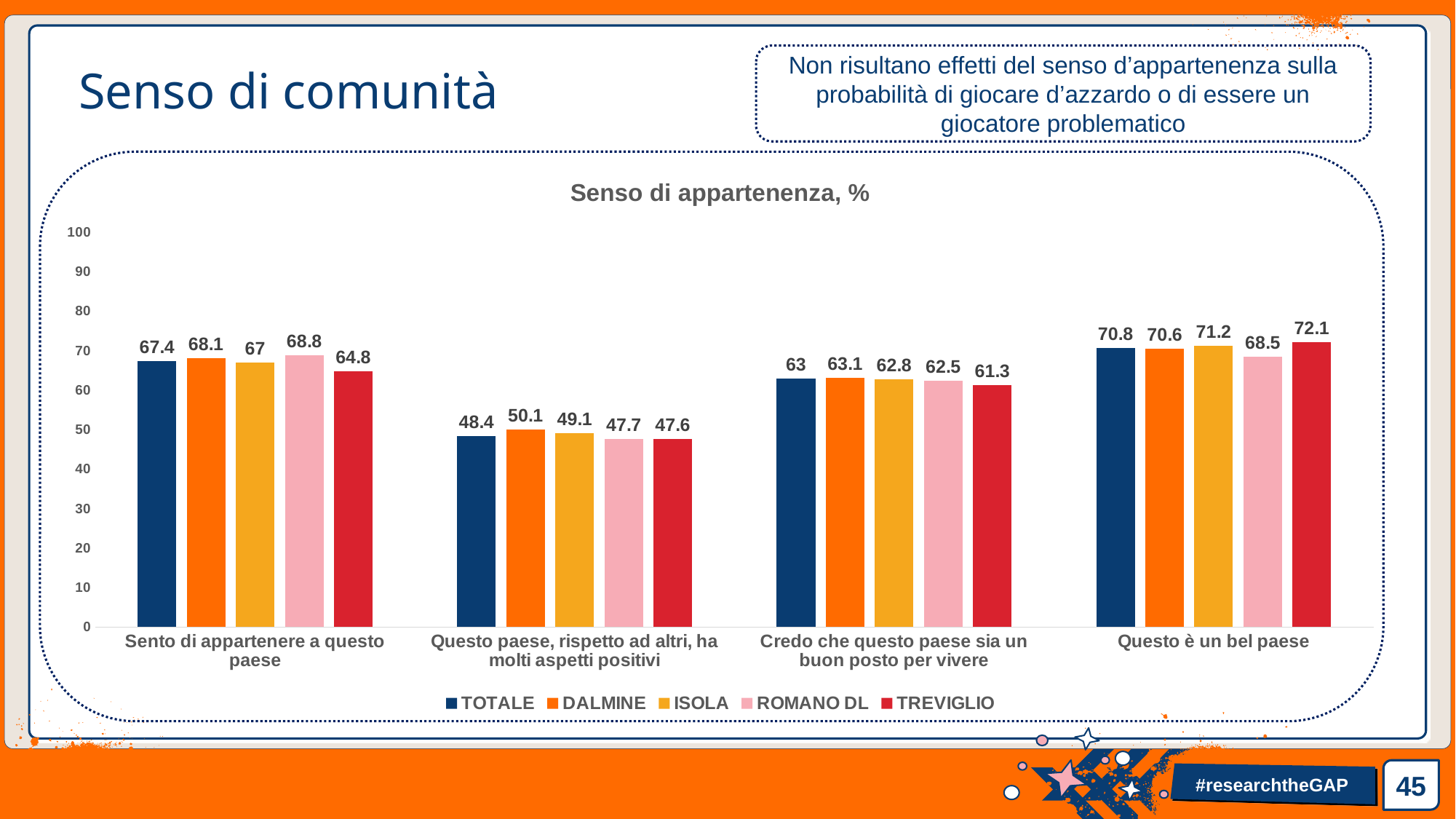
What is the value for TREVIGLIO in the category "Questo è un bel paese"? 72.1 Which is larger in the category "Questo è un bel paese": the value for ISOLA or the value for ROMANO DL? ISOLA What is the value for ROMANO DL in the category "Sento di appartenere a questo paese"? 68.8 What is the difference between the DALMINE and TREVIGLIO values in the category "Sento di appartenere a questo paese"? 3.3 Which series has the lowest value in the category "Credo che questo paese sia un buon posto per vivere"? TREVIGLIO Is the value for DALMINE in the category "Questo paese, rispetto ad altri, ha molti aspetti positivi" greater or less than 60? less What kind of chart is shown on the slide? bar chart Which series has the highest value in the category "Sento di appartenere a questo paese"? ROMANO DL What is the value for TOTALE in the category "Questo paese, rispetto ad altri, ha molti aspetti positivi"? 48.4 What is the title of the chart? Senso di appartenenza, % How many categories are shown on the x axis? 4 How many series does the legend list? 5